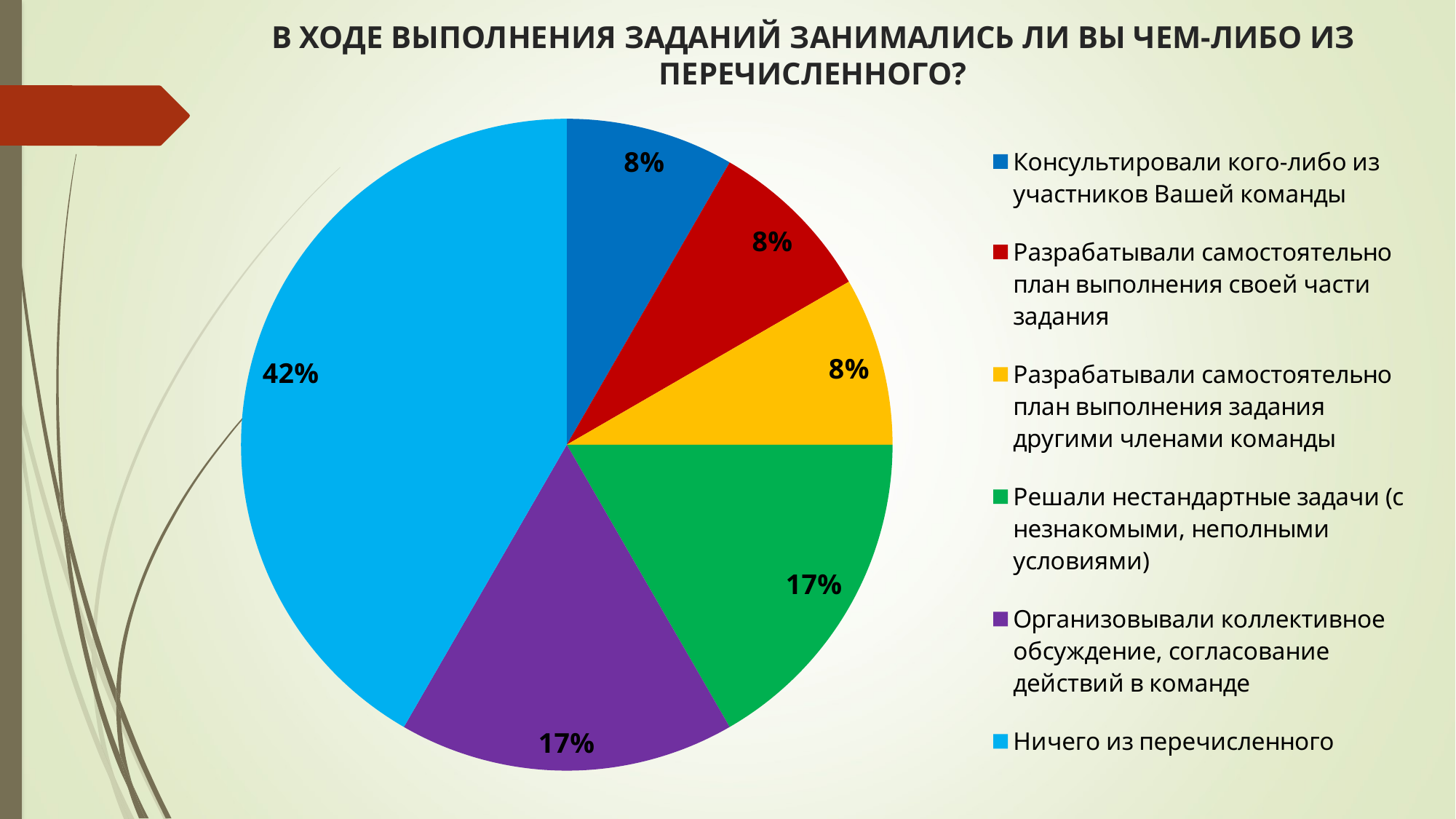
What is the value for "Разрабатывали самостоятельно план выполнения задания другими членами команды"? 8% What share of the pie does "Ничего из перечисленного" take? 42% Which is larger: the value for "Организовывали коллективное обсуждение, согласование действий в команде" or the value for "Разрабатывали самостоятельно план выполнения своей части задания"? Организовывали коллективное обсуждение, согласование действий в команде What colour is the slice for "Ничего из перечисленного"? light blue What is the title of the chart? В ХОДЕ ВЫПОЛНЕНИЯ ЗАДАНИЙ ЗАНИМАЛИСЬ ЛИ ВЫ ЧЕМ-ЛИБО ИЗ ПЕРЕЧИСЛЕННОГО? What kind of chart is shown on the slide? pie chart Which category has the largest slice of the pie? Ничего из перечисленного What is the value for "Решали нестандартные задачи (с незнакомыми, неполными условиями)"? 17% What is the value for "Организовывали коллективное обсуждение, согласование действий в команде"? 17% What is the difference between the value for "Ничего из перечисленного" and the value for "Решали нестандартные задачи (с незнакомыми, неполными условиями)"? 25% What is the value for "Консультировали кого-либо из участников Вашей команды"? 8% How many categories does the legend list? 6